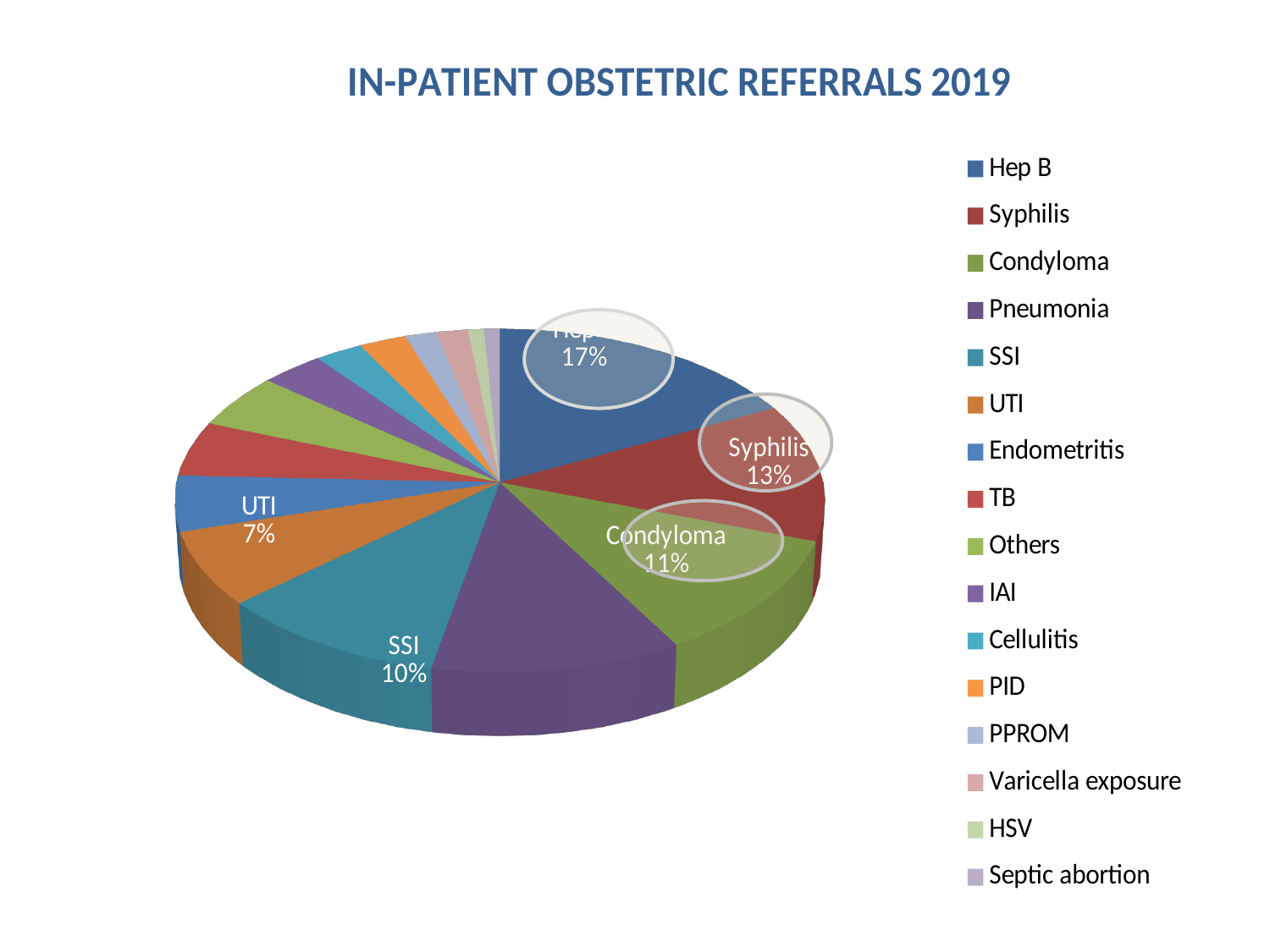
What is the title of the chart? IN-PATIENT OBSTETRIC REFERRALS 2019 Which is larger, the Syphilis slice or the Condyloma slice? Syphilis What kind of chart is shown on the slide? Pie chart How many percentage points larger is the Hep B slice than the Syphilis slice? 4% What share of referrals is UTI? 7% What share of in-patient obstetric referrals in 2019 is Hep B? 17% How many categories are listed in the legend? 16 What percentage of the pie is labelled for Syphilis? 13% What is the difference between the Hep B share and the UTI share? 10% What percentage is shown for SSI? 10% What is the value shown for Condyloma? 11% Which has the larger share, SSI or UTI? SSI